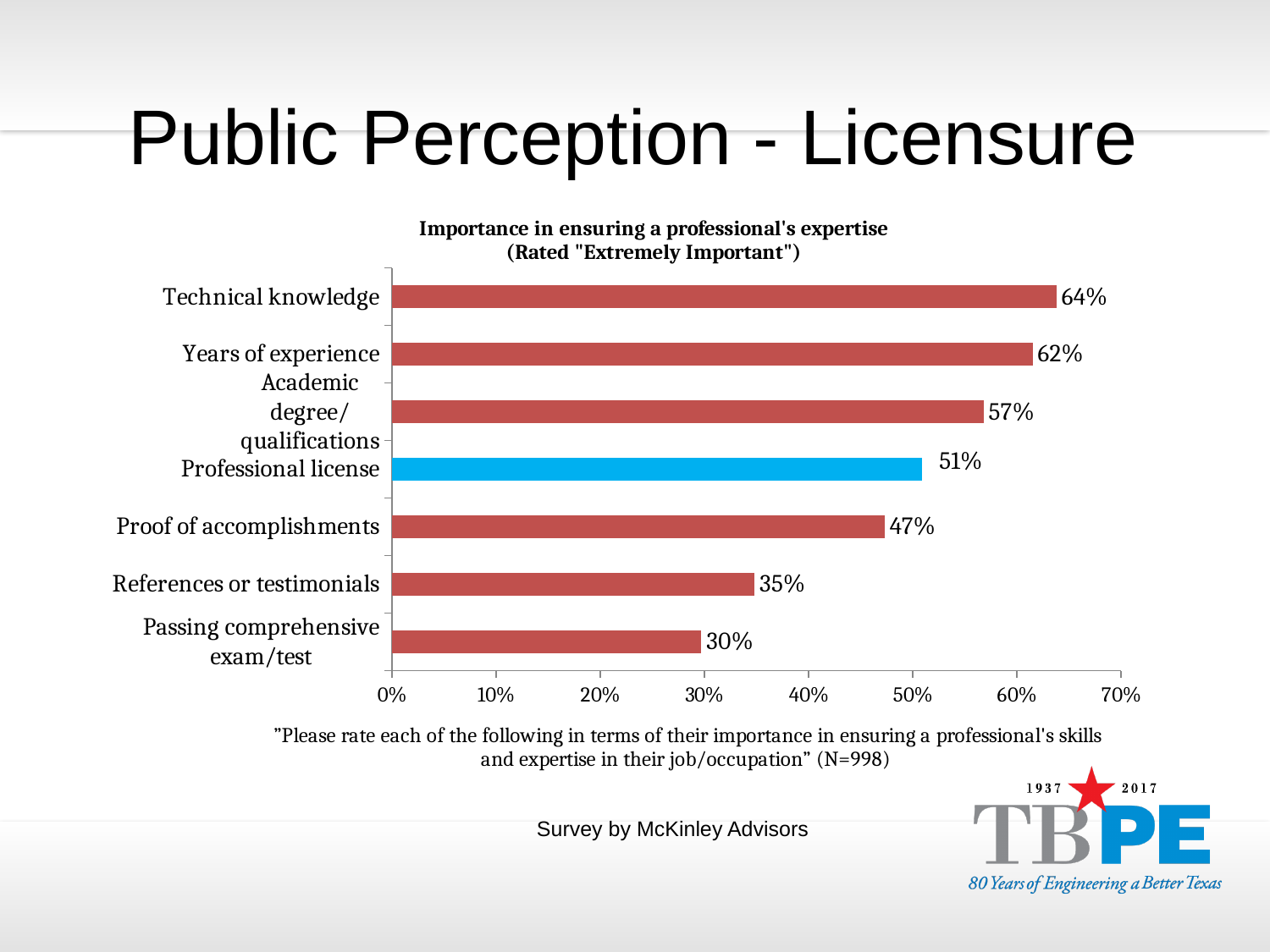
Which is larger, Proof of accomplishments or Academic degree/qualifications? Academic degree/qualifications What is the difference between Technical knowledge and Professional license? 13% What percentage rated Technical knowledge as extremely important? 64% What is the difference between Years of experience and References or testimonials? 27% What is the title of the chart? Importance in ensuring a professional's expertise (Rated "Extremely Important") What is the value for Passing comprehensive exam/test? 30% Which bar is shown in a different colour (blue) from the others? Professional license Which category has the lowest value? Passing comprehensive exam/test What is the value for Professional license? 51% How many categories are shown in the chart? 7 Which category has the highest value? Technical knowledge What kind of chart is shown on the slide? Bar chart